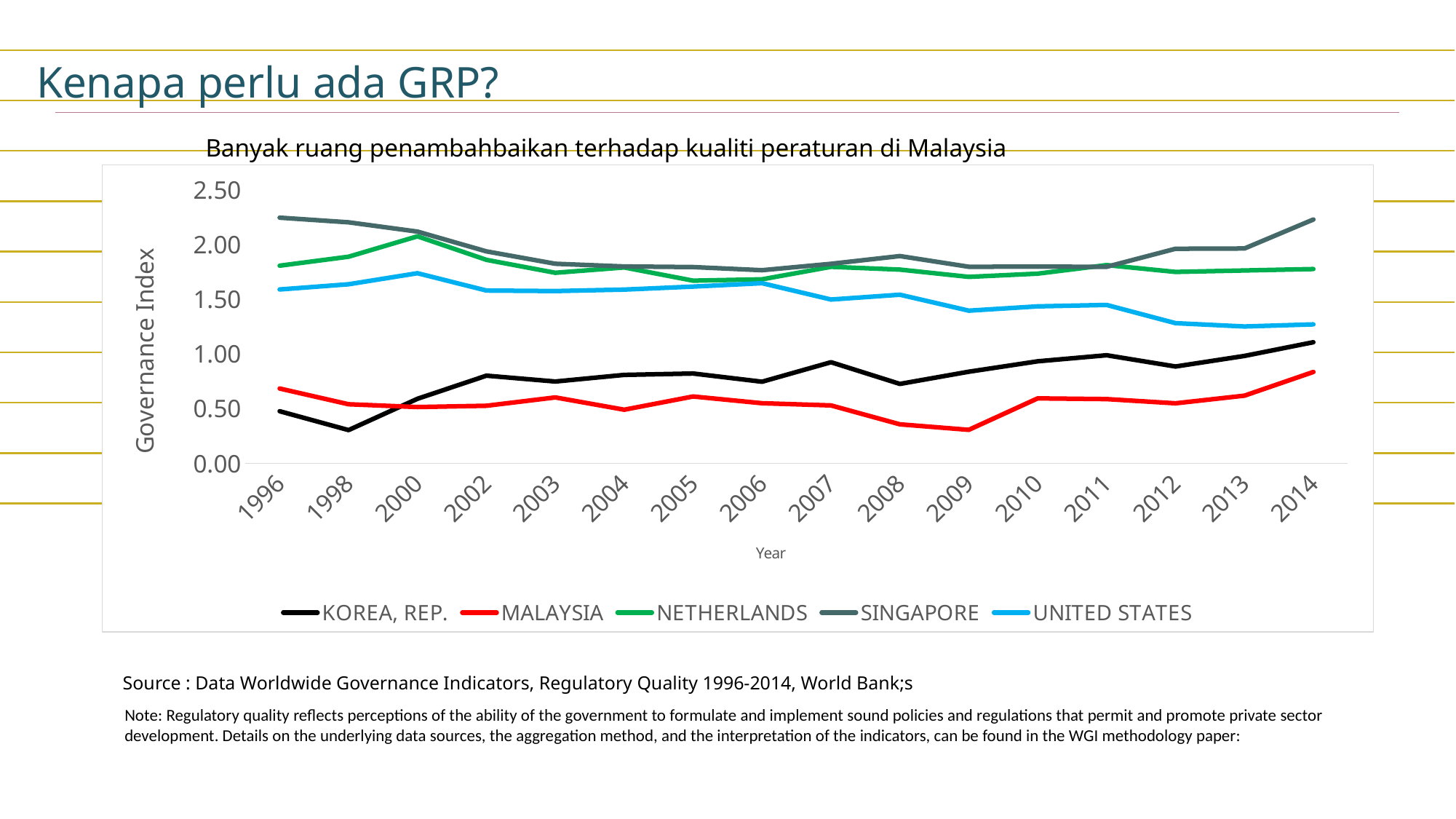
Which country has the highest Governance Index in 1996? SINGAPORE What is the label of the y axis? Governance Index How many series does the legend list? 5 Is the value for SINGAPORE in 1996 greater or less than 2.00? greater Is the value for KOREA, REP. in 2014 greater or less than 1.00? greater Does the Governance Index for UNITED STATES rise or fall from 1996 to 2014? fall How many years are shown on the x axis? 16 Is the value for MALAYSIA in 2009 greater or less than 0.50? less What kind of chart is shown on the slide? line chart Which country has the lowest Governance Index in 2009? MALAYSIA In 2014, which is larger: the value for KOREA, REP. or the value for MALAYSIA? KOREA, REP.